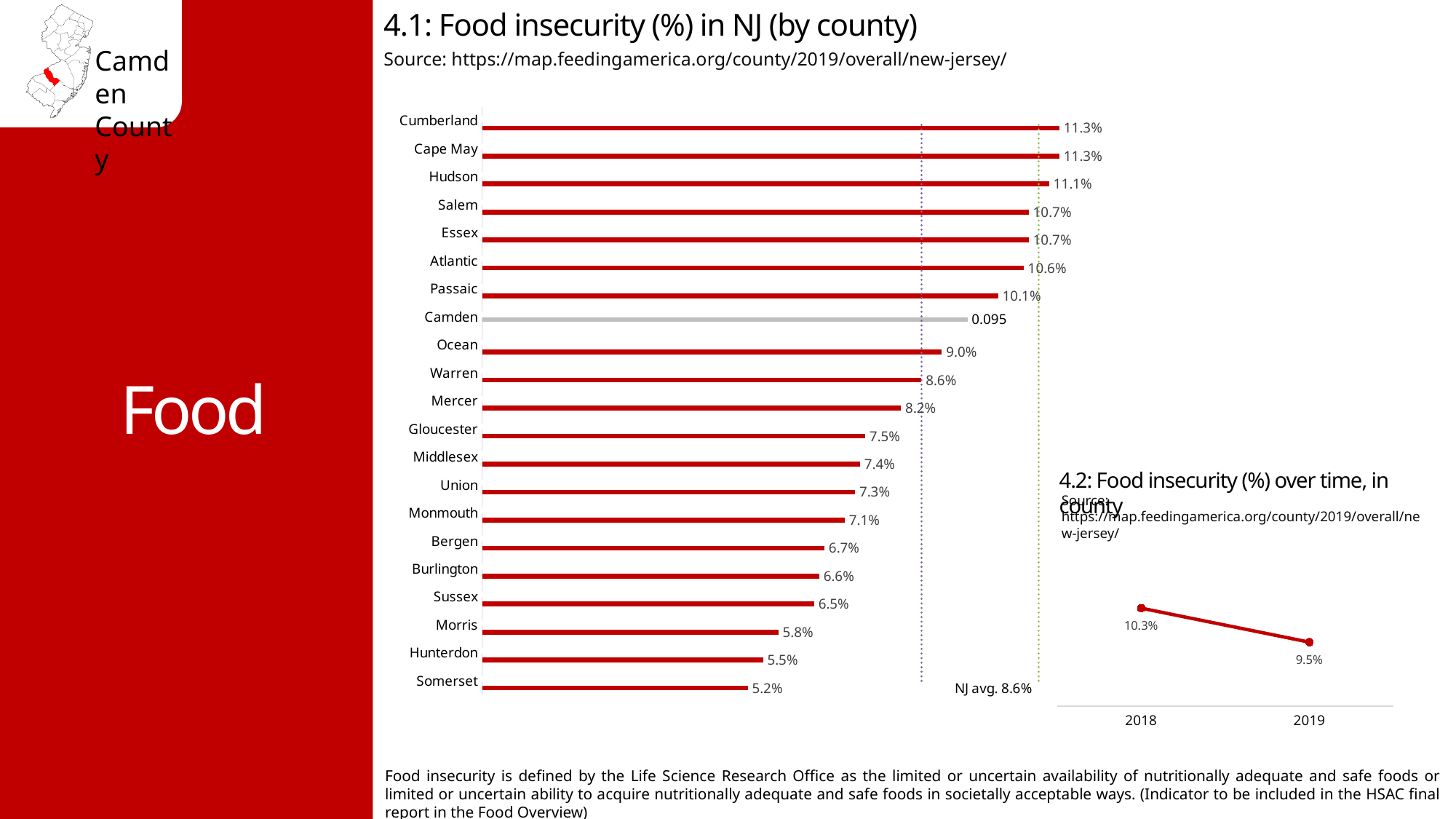
What kind of chart is chart 4.1 (Food insecurity (%) in NJ by county)? Bar chart In chart 4.1 (Food insecurity (%) in NJ by county), what NJ average is labelled on the chart? NJ avg. 8.6% In chart 4.1 (Food insecurity (%) in NJ by county), which county has the lowest food insecurity? Somerset In chart 4.1 (Food insecurity (%) in NJ by county), what is the difference between Hudson and Somerset? 5.9 percentage points In chart 4.2 (Food insecurity (%) over time, in county), what is the value for 2018? 10.3% In chart 4.1 (Food insecurity (%) in NJ by county), what is the value for Hudson? 11.1% In chart 4.2 (Food insecurity (%) over time, in county), what is the difference between the 2018 and 2019 values? 0.8 percentage points In chart 4.1 (Food insecurity (%) in NJ by county), how many counties are plotted? 21 In chart 4.1 (Food insecurity (%) in NJ by county), what is the value for Gloucester? 7.5% In chart 4.1 (Food insecurity (%) in NJ by county), what value is labelled for Camden? 0.095 In chart 4.2 (Food insecurity (%) over time, in county), does the value rise or fall from 2018 to 2019? Fall In chart 4.1 (Food insecurity (%) in NJ by county), which is larger, the value for Ocean or the value for Mercer? Ocean